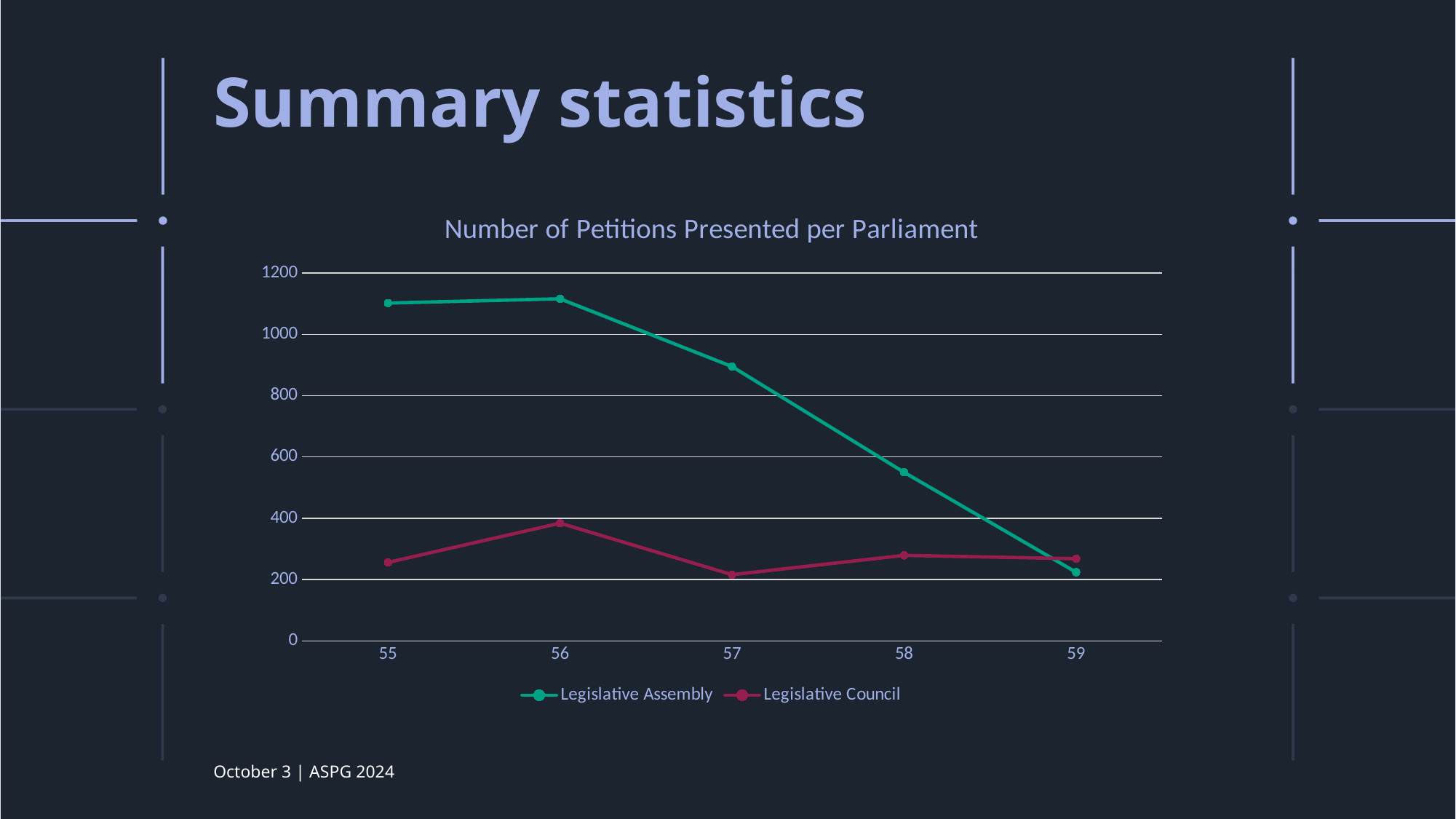
What is the title of the chart? Number of Petitions Presented per Parliament Which series has the larger value in parliament 57, Legislative Assembly or Legislative Council? Legislative Assembly How many series does the legend list? 2 What type of chart is shown on the slide? line chart In which parliament is the Legislative Council value lowest? 57 In which parliament is the Legislative Council value highest? 56 In which parliament is the Legislative Assembly value lowest? 59 Is the Legislative Assembly value for parliament 58 greater or less than 600? less Does the Legislative Assembly line rise or fall from parliament 56 to parliament 59? fall How many parliaments are plotted along the x axis? 5 Is the Legislative Assembly value for parliament 57 greater or less than 800? greater